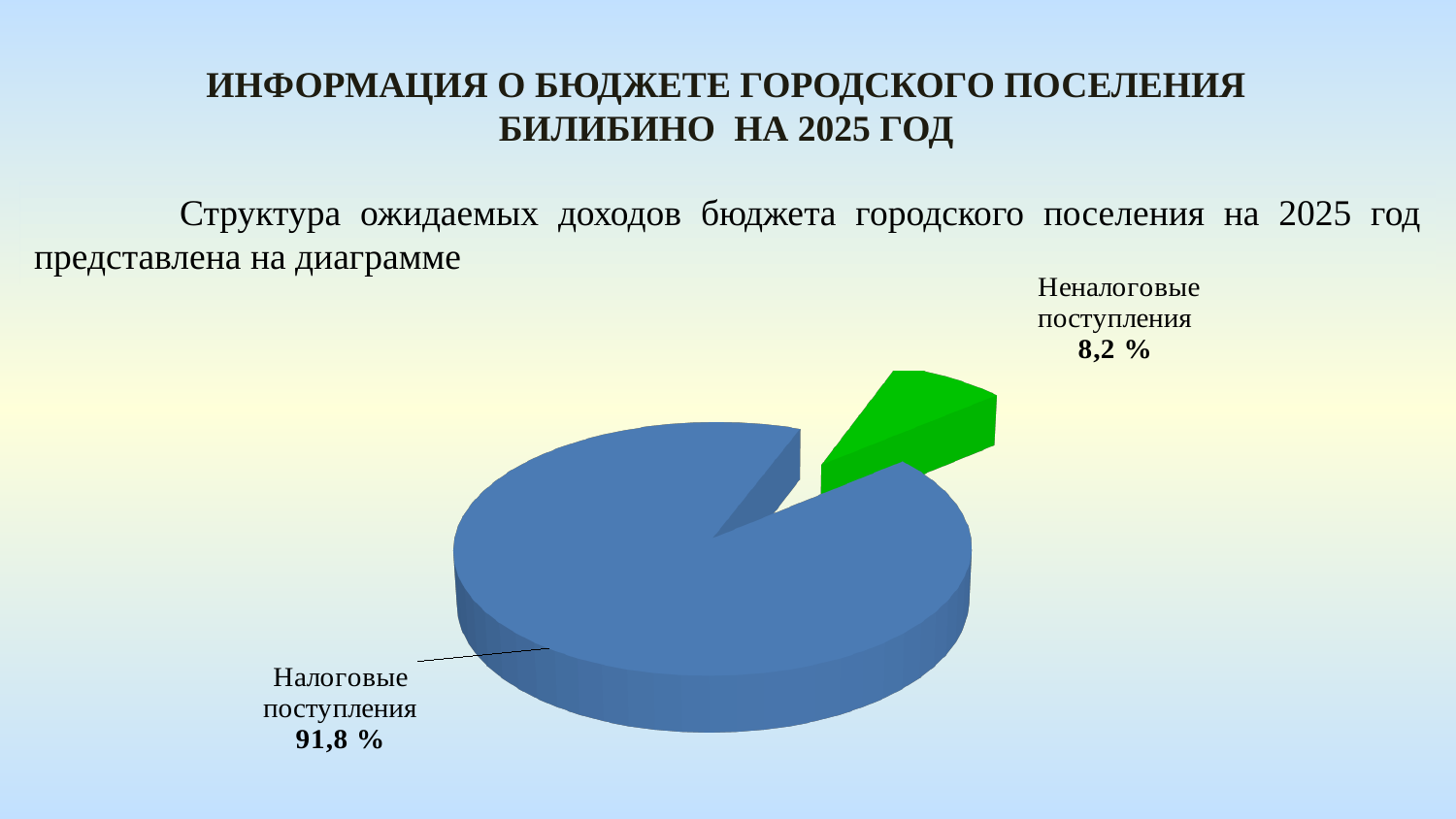
What is the total of the two slice percentages shown on the pie chart? 100 % What colour is the slice for Налоговые поступления? blue What colour is the slice for Неналоговые поступления? green What is the difference in percentage points between Налоговые поступления and Неналоговые поступления? 83,6 What share of the pie is labelled Налоговые поступления? 91,8 % What kind of chart is shown on the slide? pie chart What share of the pie is labelled Неналоговые поступления? 8,2 % Which slice of the pie is the smallest? Неналоговые поступления How many slices does the pie chart have? 2 Which is larger: Налоговые поступления or Неналоговые поступления? Налоговые поступления Which slice of the pie is the largest? Налоговые поступления